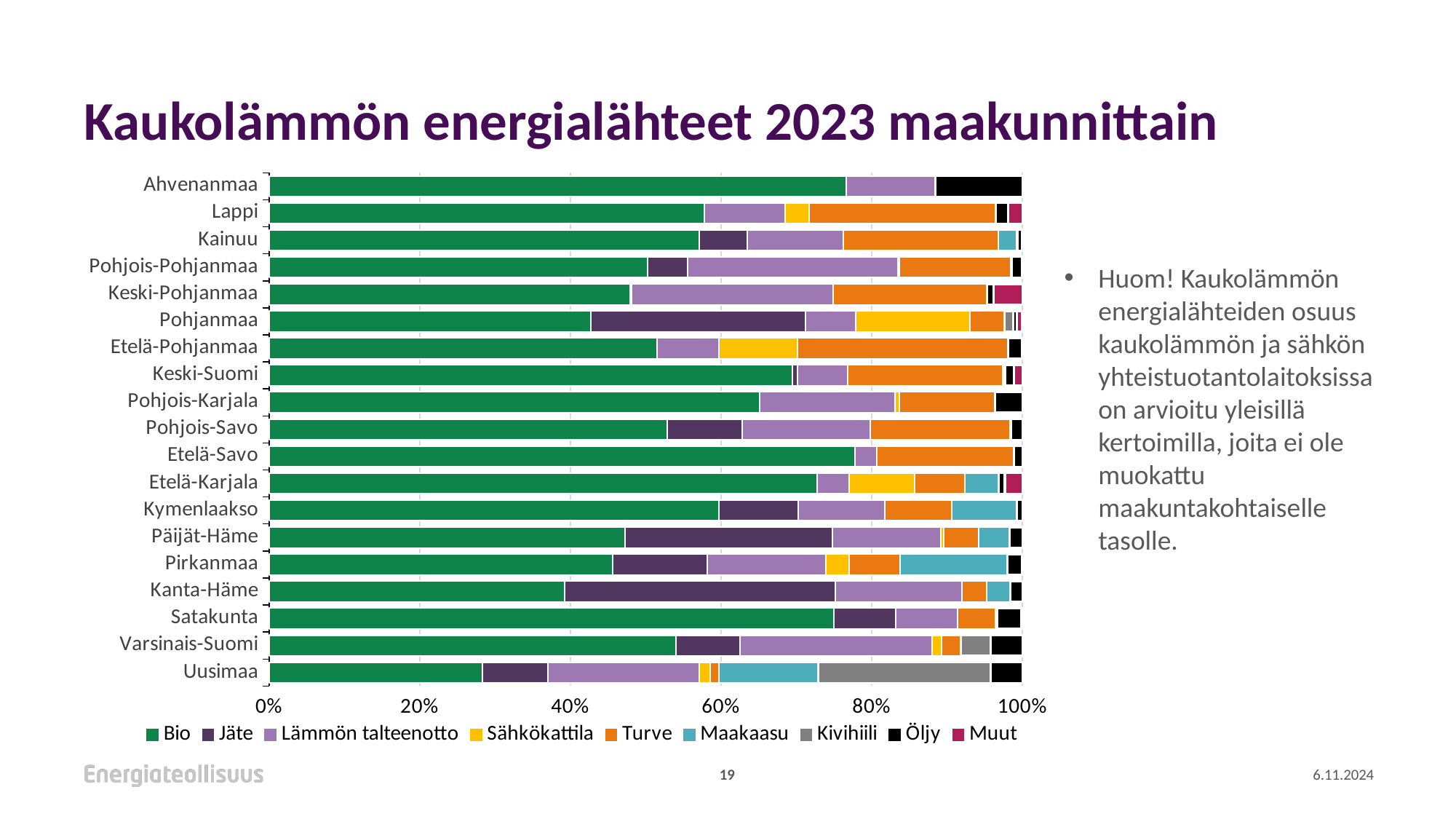
How many series does the chart legend list? 9 Which region has a larger Bio share, Satakunta or Pirkanmaa? Satakunta Which colour represents Turve in the chart legend? Orange Which region has the largest Jäte share in the chart? Kanta-Häme Which region has the largest Kivihiili share in the chart? Uusimaa What kind of chart is shown on the slide? Stacked bar chart Which region has the smallest Bio share in the chart? Uusimaa Is the Bio share for Uusimaa greater or less than 40%? less What is the title of the chart on the slide? Kaukolämmön energialähteet 2023 maakunnittain Which region has the largest Öljy share in the chart? Ahvenanmaa Is the Bio share for Ahvenanmaa greater or less than 60%? greater How many regions (categories) are listed on the vertical axis of the chart? 19